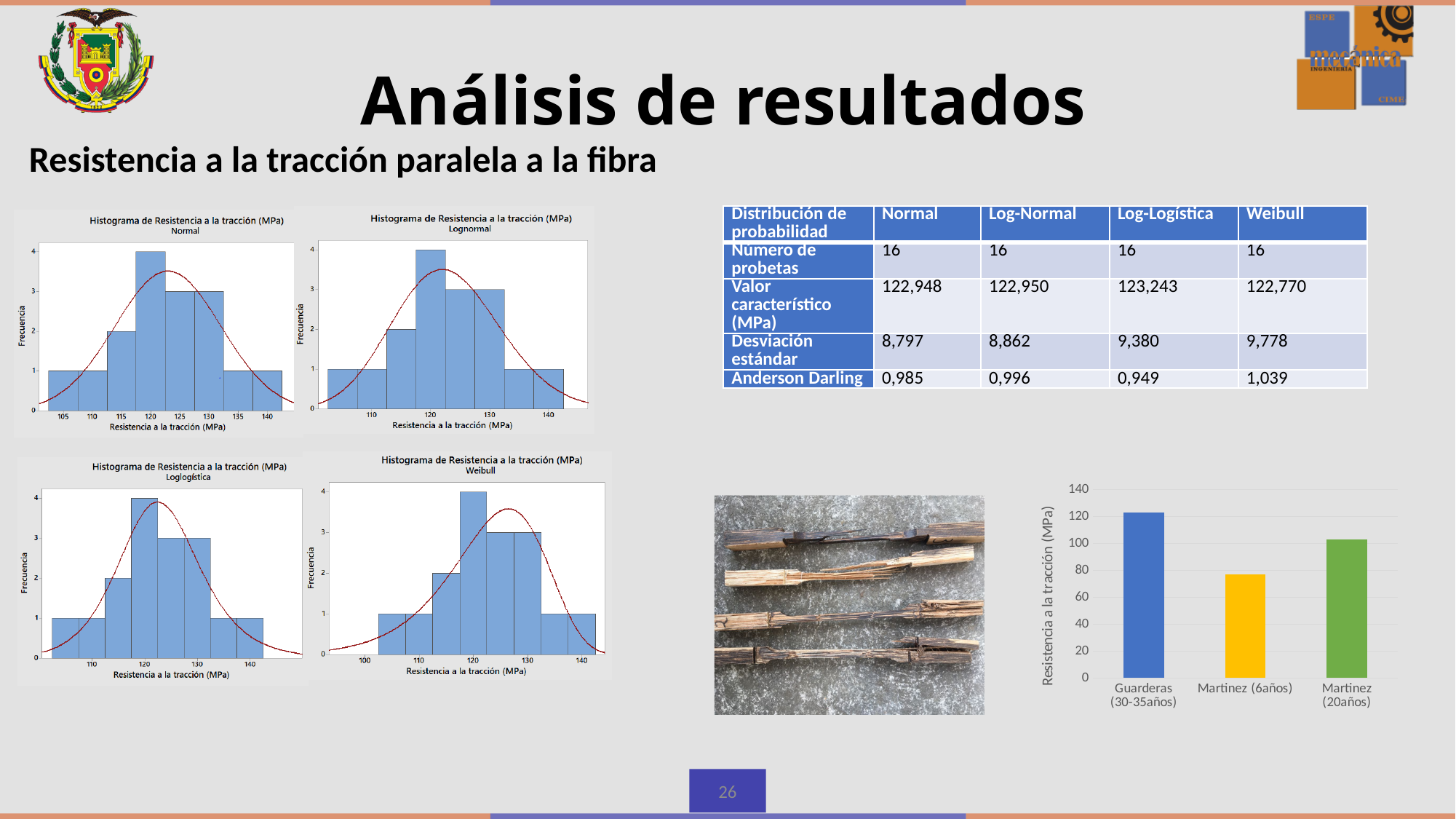
What is the y-axis label of the bar chart at the bottom right? Resistencia a la tracción (MPa) How many categories are shown in the bar chart at the bottom right? 3 In the bar chart at the bottom right, is the value for Guarderas (30-35años) greater or less than 120? greater In the bar chart at the bottom right, is the value for Martinez (6años) greater or less than 80? less In the histogram titled 'Histograma de Resistencia a la tracción (MPa) Normal', what is the highest frequency reached by any bar? 4 What kind of chart is shown at the bottom right of the slide? bar chart In the bar chart at the bottom right, which category has the lowest value? Martinez (6años) In the bar chart at the bottom right, which is larger, the value for Martinez (6años) or Martinez (20años)? Martinez (20años) In the bar chart at the bottom right, is the value for Martinez (20años) greater or less than 100? greater How many bars are there in the histogram titled 'Histograma de Resistencia a la tracción (MPa) Normal'? 8 In the bar chart at the bottom right, which category has the highest value? Guarderas (30-35años) What is the y-axis label of the histogram titled 'Histograma de Resistencia a la tracción (MPa) Weibull'? Frecuencia